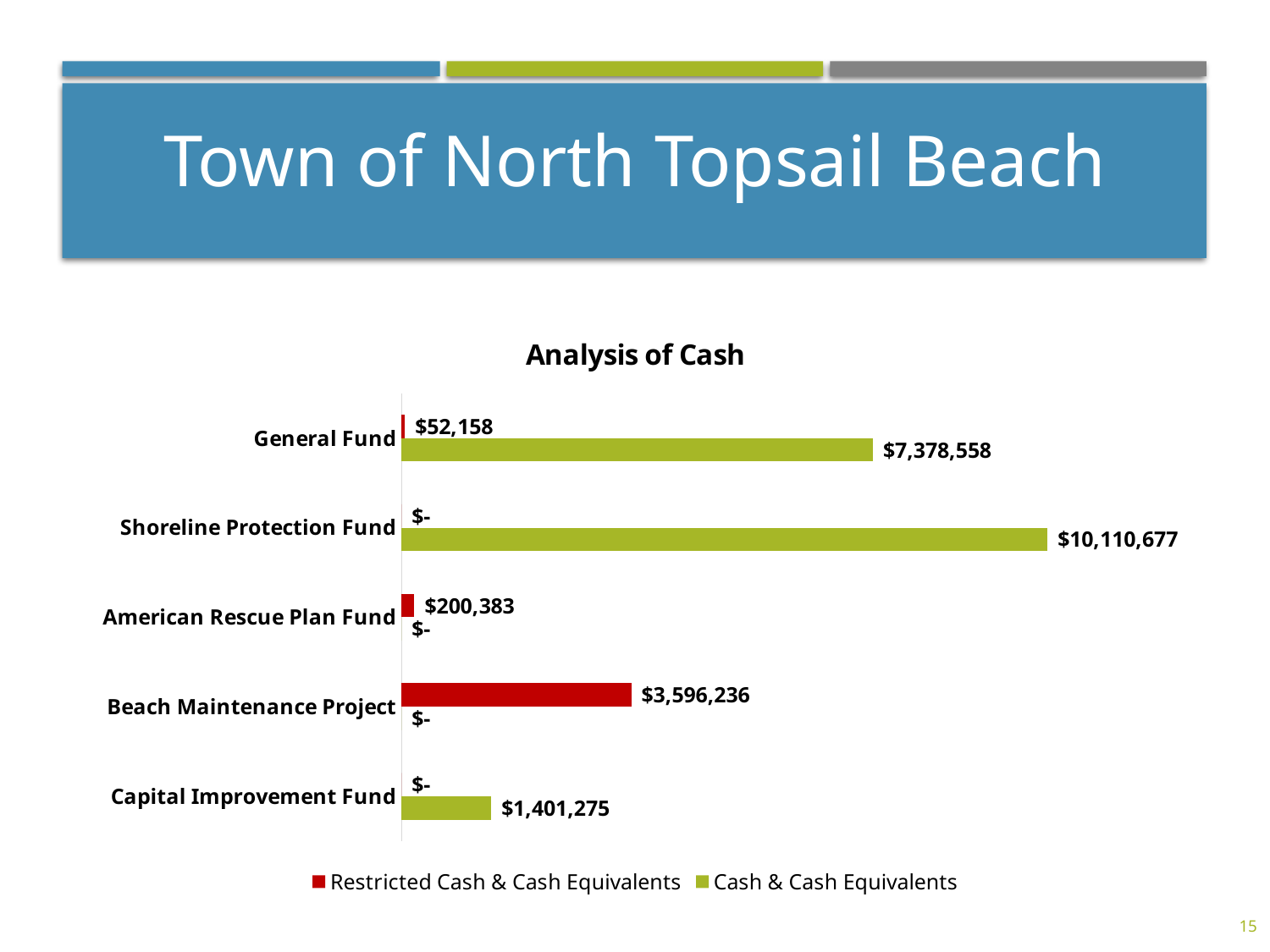
Which is larger: the General Fund's Cash & Cash Equivalents or the Beach Maintenance Project's Restricted Cash & Cash Equivalents? General Fund's Cash & Cash Equivalents What is the Cash & Cash Equivalents value for the Capital Improvement Fund? $1,401,275 What is the Cash & Cash Equivalents value for the General Fund? $7,378,558 Which fund has the highest Cash & Cash Equivalents value? Shoreline Protection Fund What is the difference between the Cash & Cash Equivalents values of the Shoreline Protection Fund and the General Fund? $2,732,119 What is the Restricted Cash & Cash Equivalents value for the Beach Maintenance Project? $3,596,236 What type of chart is shown under the title 'Analysis of Cash'? bar chart How many series does the legend list? 2 How many funds are shown on the chart? 5 What is the difference between the Restricted Cash & Cash Equivalents values of the Beach Maintenance Project and the American Rescue Plan Fund? $3,395,853 What is the Restricted Cash & Cash Equivalents value for the American Rescue Plan Fund? $200,383 Which fund has the highest Restricted Cash & Cash Equivalents value? Beach Maintenance Project